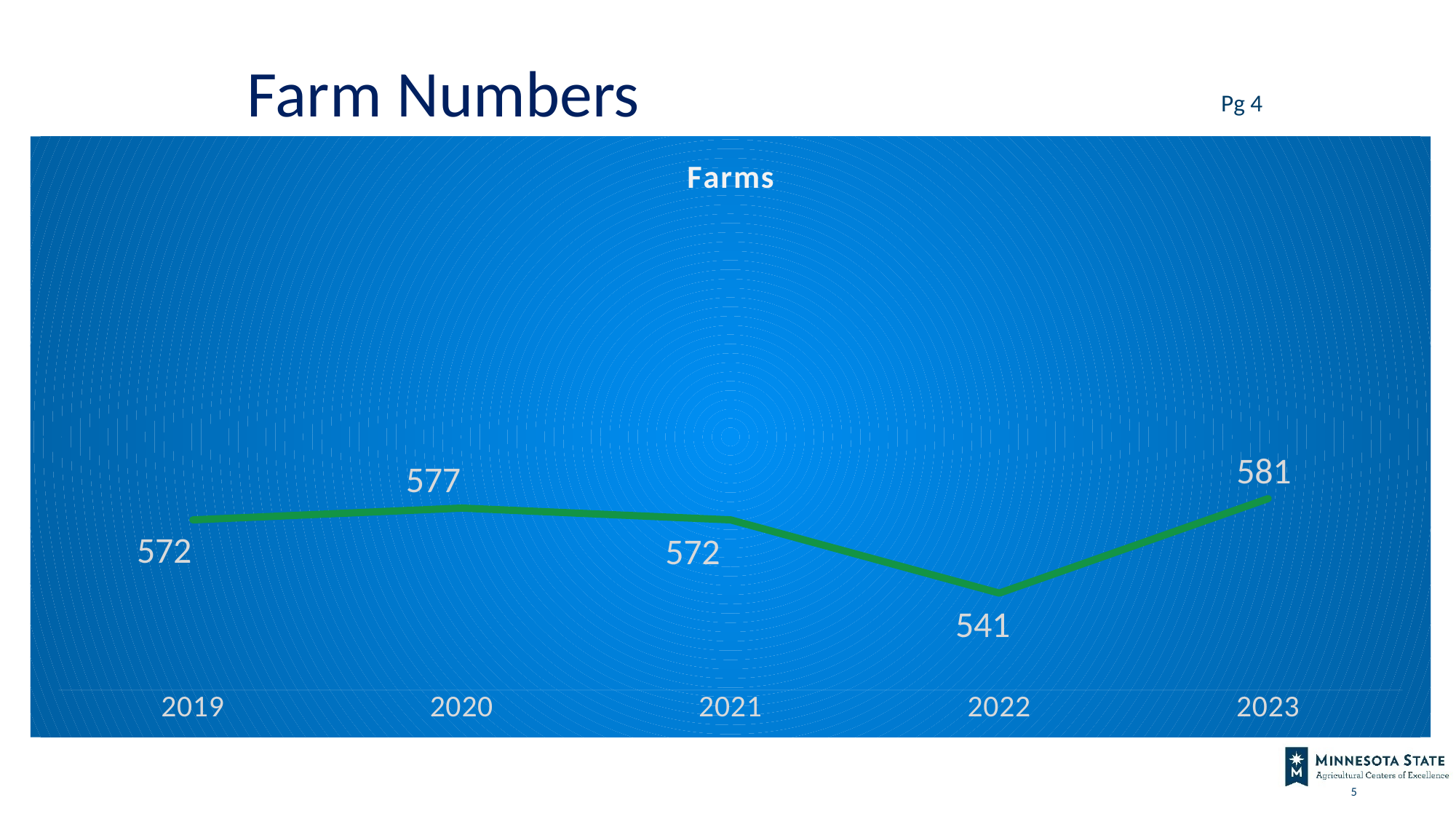
What kind of chart is shown on the slide? Line chart Which year has the highest number of farms? 2023 What is the number of farms in 2020? 577 What is the difference in farm numbers between 2023 and 2022? 40 How many years are plotted on the chart? 5 Which year has more farms, 2021 or 2022? 2021 What is the number of farms in 2023? 581 What is the number of farms in 2022? 541 What is the difference in farm numbers between 2020 and 2019? 5 Which year has the lowest number of farms? 2022 What is the number of farms in 2019? 572 What is the title of the chart? Farms